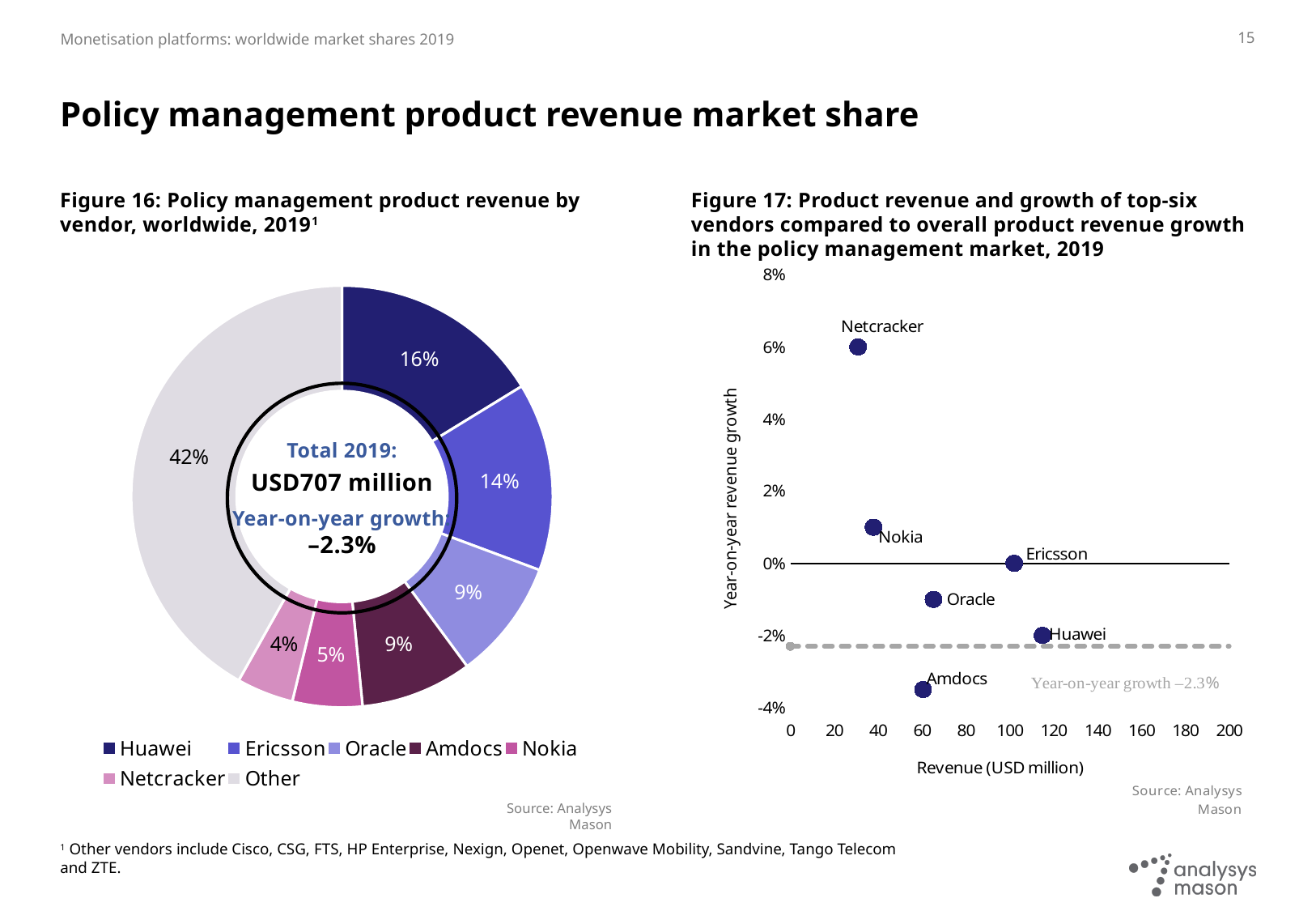
In Figure 17, which vendor has the lowest year-on-year revenue growth? Amdocs In Figure 16, what is the difference in percentage points between Huawei's share and Ericsson's share? 2 percentage points In Figure 16, which vendor category has the largest share? Other In Figure 16, which named vendor has the smallest share? Netcracker In Figure 17, which vendor has the highest year-on-year revenue growth? Netcracker How many vendor categories does the legend of Figure 16 list? 7 What total 2019 revenue is shown in the centre of Figure 16? USD707 million In Figure 16, what share of policy management product revenue does Huawei hold? 16% In Figure 16, which has the larger share, Oracle or Nokia? Oracle What kind of chart is Figure 17? Scatter chart In Figure 16, what share of revenue is attributed to Other vendors? 42% In Figure 17, is Huawei's revenue greater or less than 100 USD million? greater